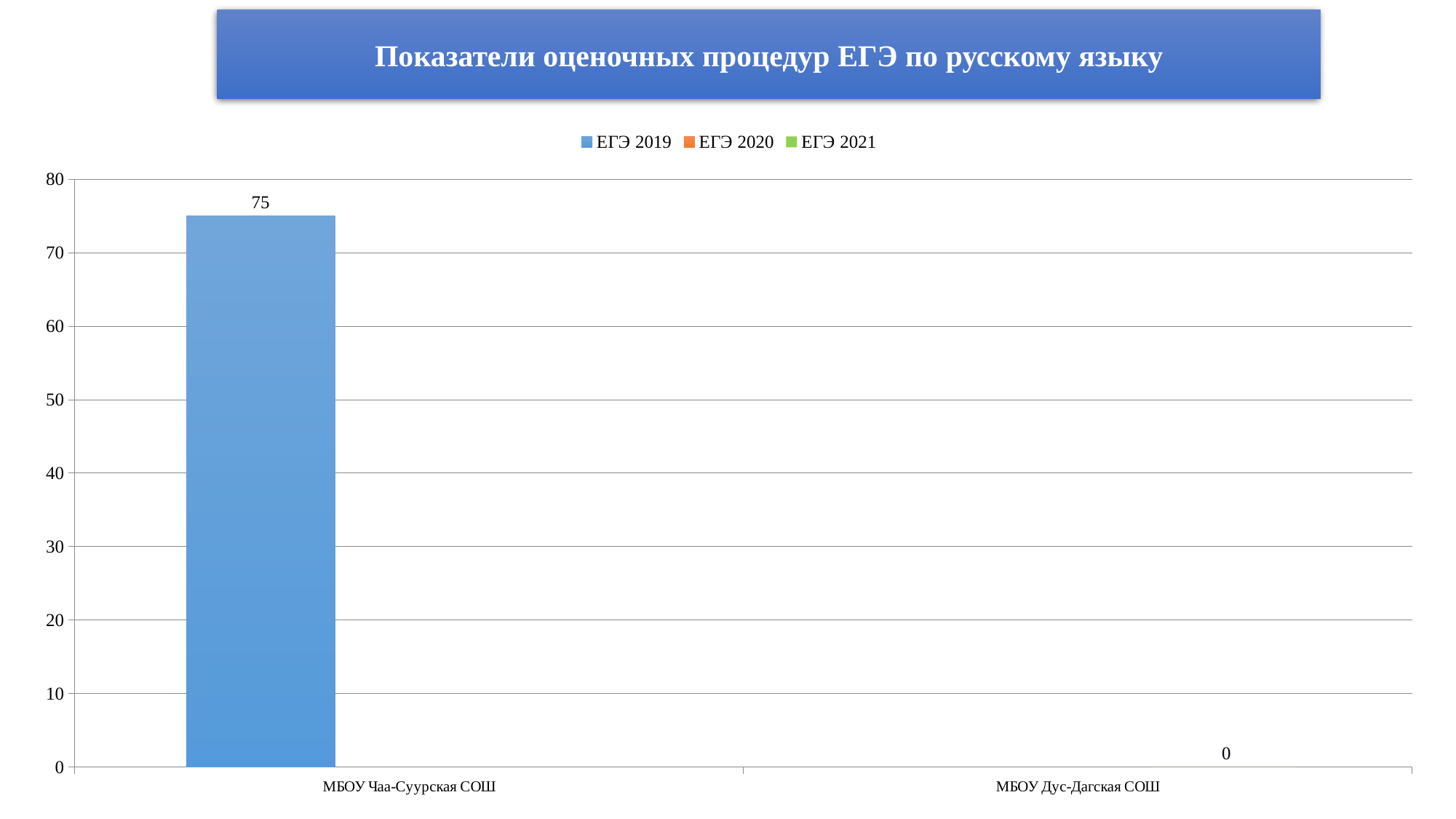
What value is labelled for МБОУ Дус-Дагская СОШ? 0 Which category has the lowest labelled value? МБОУ Дус-Дагская СОШ Which is larger: the value for МБОУ Чаа-Суурская СОШ or the value for МБОУ Дус-Дагская СОШ? МБОУ Чаа-Суурская СОШ What kind of chart is shown on the slide? bar chart How many categories are shown on the x axis? 2 Is the value for ЕГЭ 2019 at МБОУ Чаа-Суурская СОШ greater or less than 70? greater Which series is shown in blue in the legend? ЕГЭ 2019 What is the title of the chart? Показатели оценочных процедур ЕГЭ по русскому языку Which category has the highest plotted value? МБОУ Чаа-Суурская СОШ How many series does the legend list? 3 What is the value for ЕГЭ 2019 at МБОУ Чаа-Суурская СОШ? 75 What is the difference between the value for МБОУ Чаа-Суурская СОШ (75) and the value labelled for МБОУ Дус-Дагская СОШ (0)? 75